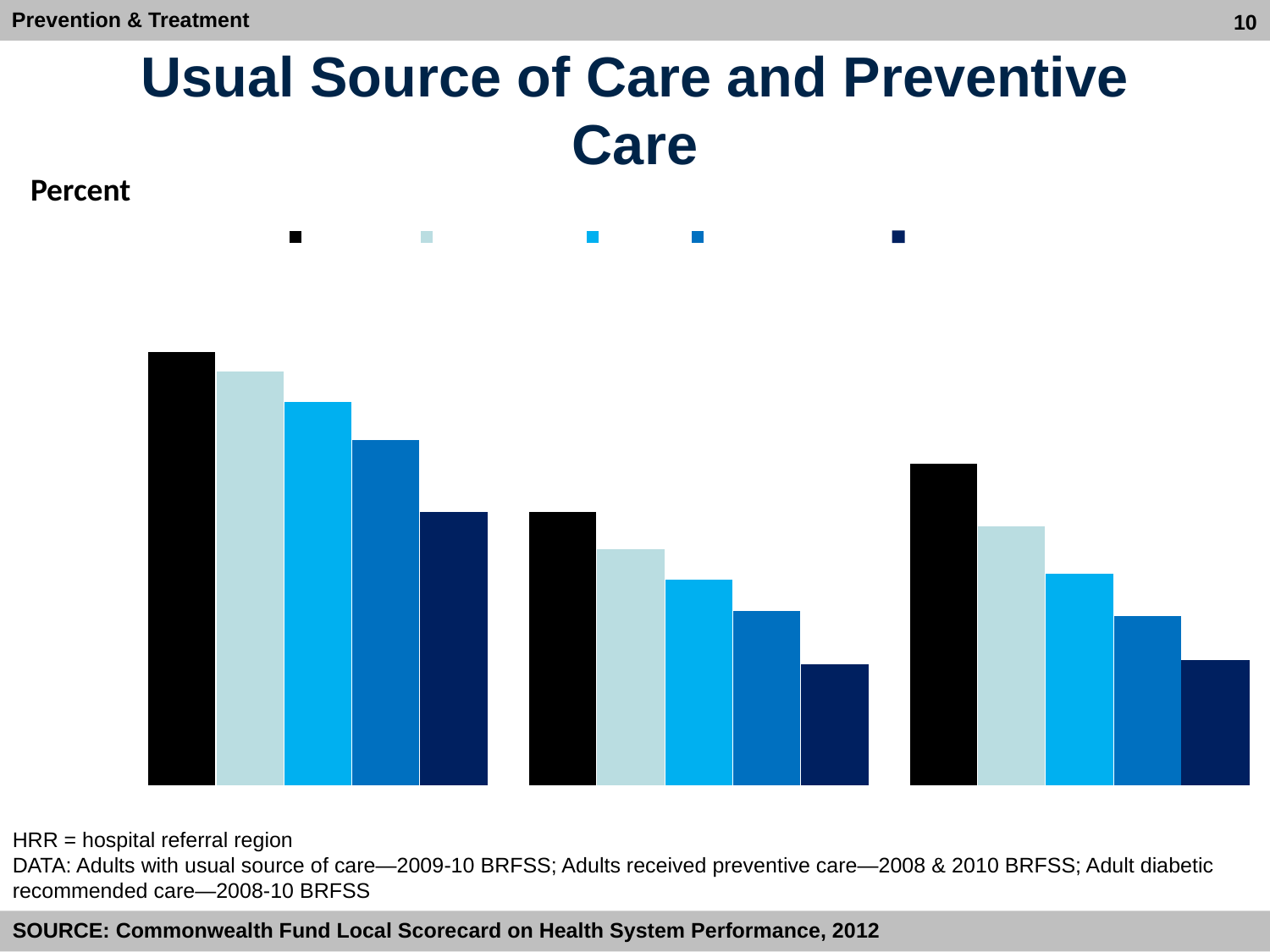
How many series does the legend list? 5 Which group of bars has the lowest first (black) bar? the middle group Which group of bars contains the tallest bar on the chart? the leftmost group What kind of chart is shown on the slide? bar chart Is the first (black) bar of the middle group taller or shorter than the first (black) bar of the rightmost group? shorter Is the first (black) bar of the leftmost group taller or shorter than the first (black) bar of the rightmost group? taller Within each group, do the bars rise or fall from left to right? fall What label is shown for the vertical axis? Percent How many bars are in each group? 5 What is the title of the chart? Usual Source of Care and Preventive Care How many groups of bars are plotted on the chart? 3